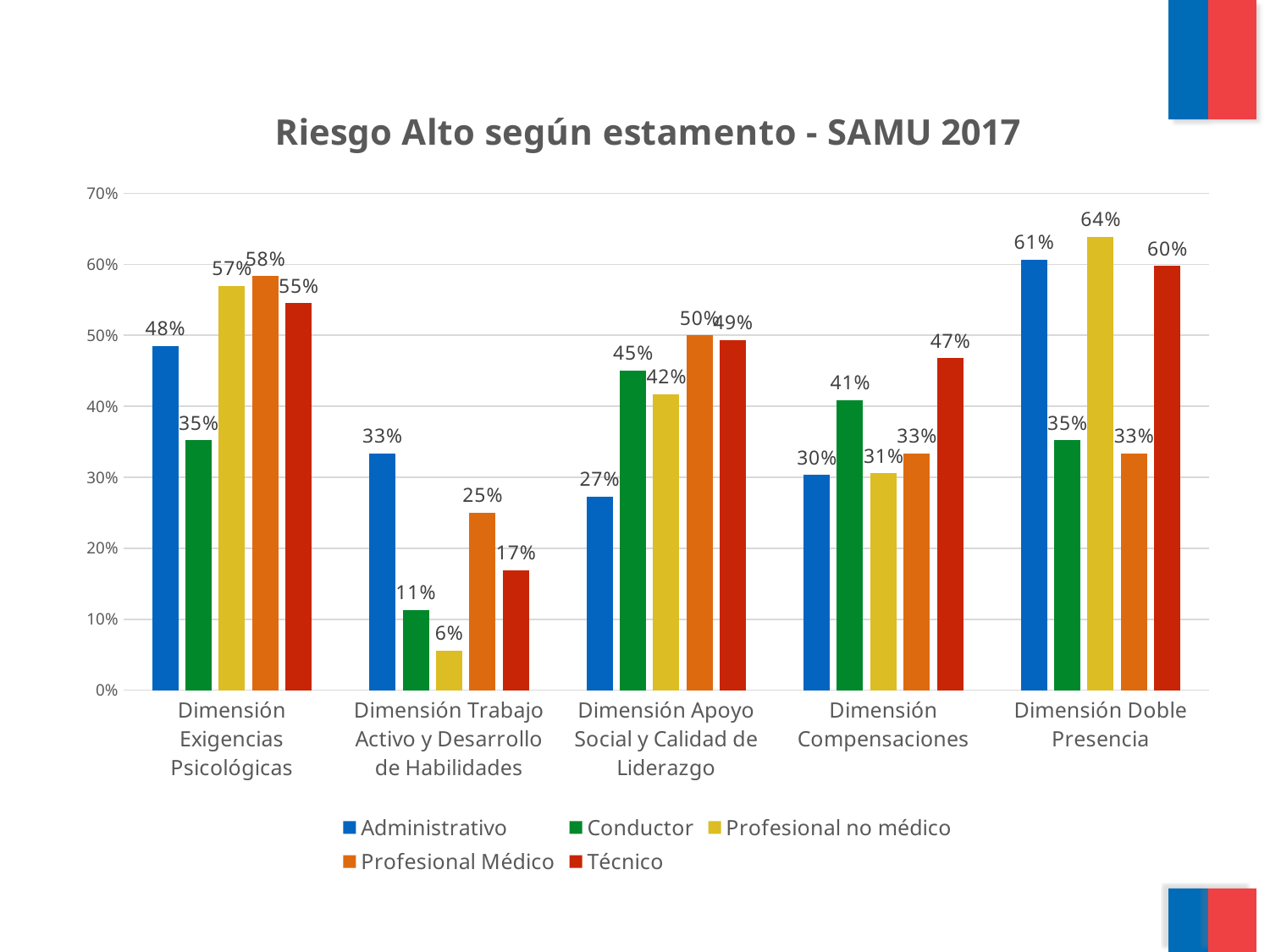
What is the title of the chart? Riesgo Alto según estamento - SAMU 2017 What is the difference between the Administrativo and Conductor values in Dimensión Trabajo Activo y Desarrollo de Habilidades? 22% What type of chart is shown on the slide? bar chart Which series has the highest value in Dimensión Doble Presencia? Profesional no médico Which series is shown in green in the legend? Conductor How many series does the legend list? 5 How many dimension categories are shown on the x axis? 5 In Dimensión Compensaciones, which is larger: the value for Conductor or the value for Profesional Médico? Conductor What is the value for Profesional no médico in Dimensión Trabajo Activo y Desarrollo de Habilidades? 6% What is the value for Administrativo in Dimensión Exigencias Psicológicas? 48% Which series has the lowest value in Dimensión Apoyo Social y Calidad de Liderazgo? Administrativo What is the value for Técnico in Dimensión Compensaciones? 47%